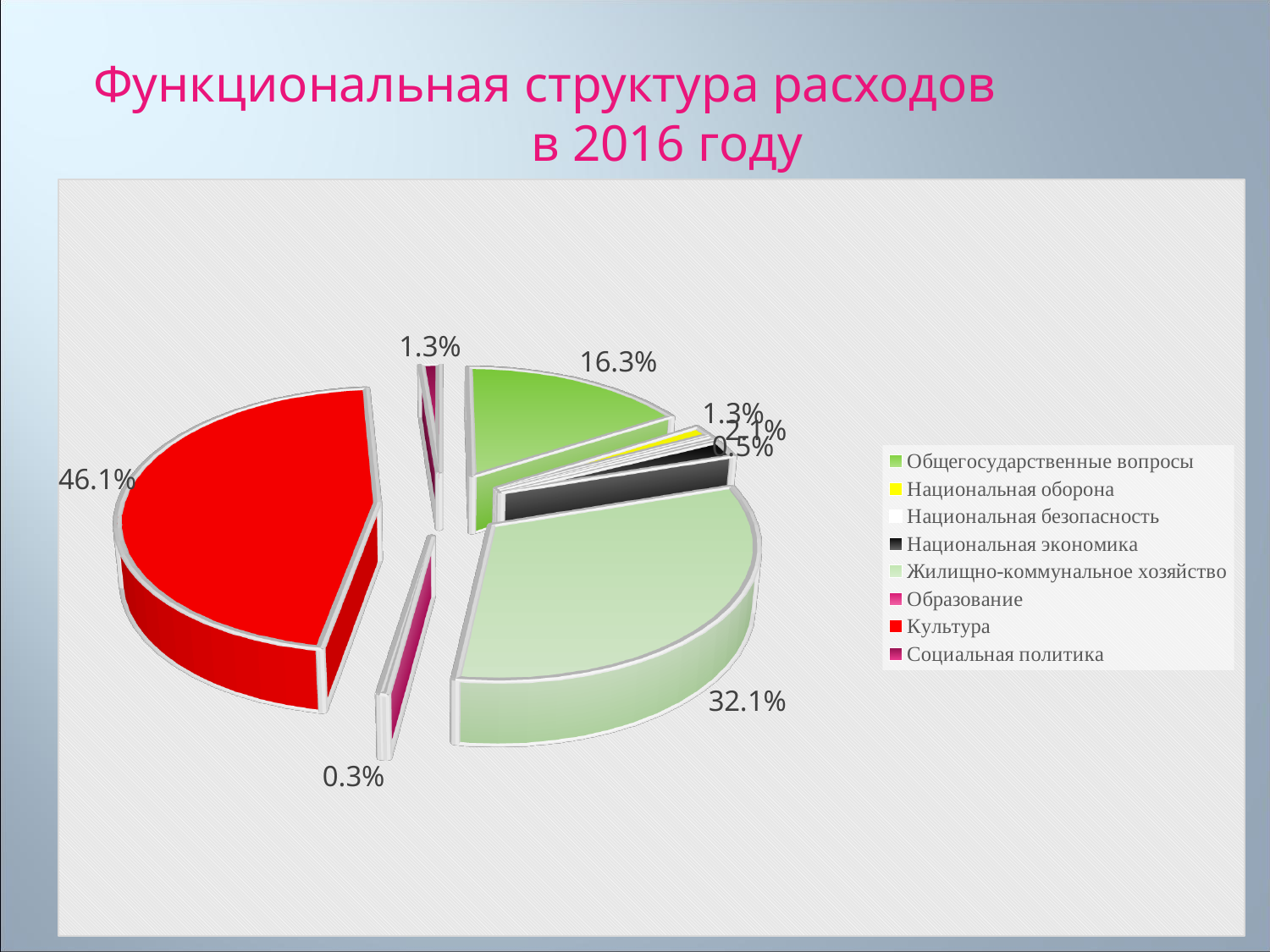
What colour is the slice for Культура? red How many categories does the legend of the pie chart list? 8 What share of the pie does Образование have? 0.3% Which is larger, the share of Общегосударственные вопросы or the share of Жилищно-коммунальное хозяйство? Жилищно-коммунальное хозяйство What share of the pie does Общегосударственные вопросы have? 16.3% What is the title of the slide's chart? Функциональная структура расходов в 2016 году What share of the pie does Жилищно-коммунальное хозяйство have? 32.1% Which category has the smallest share of the pie? Образование Which category has the largest share of the pie? Культура What kind of chart is shown on the slide? pie chart What is the difference between the shares of Культура and Жилищно-коммунальное хозяйство? 14.0%